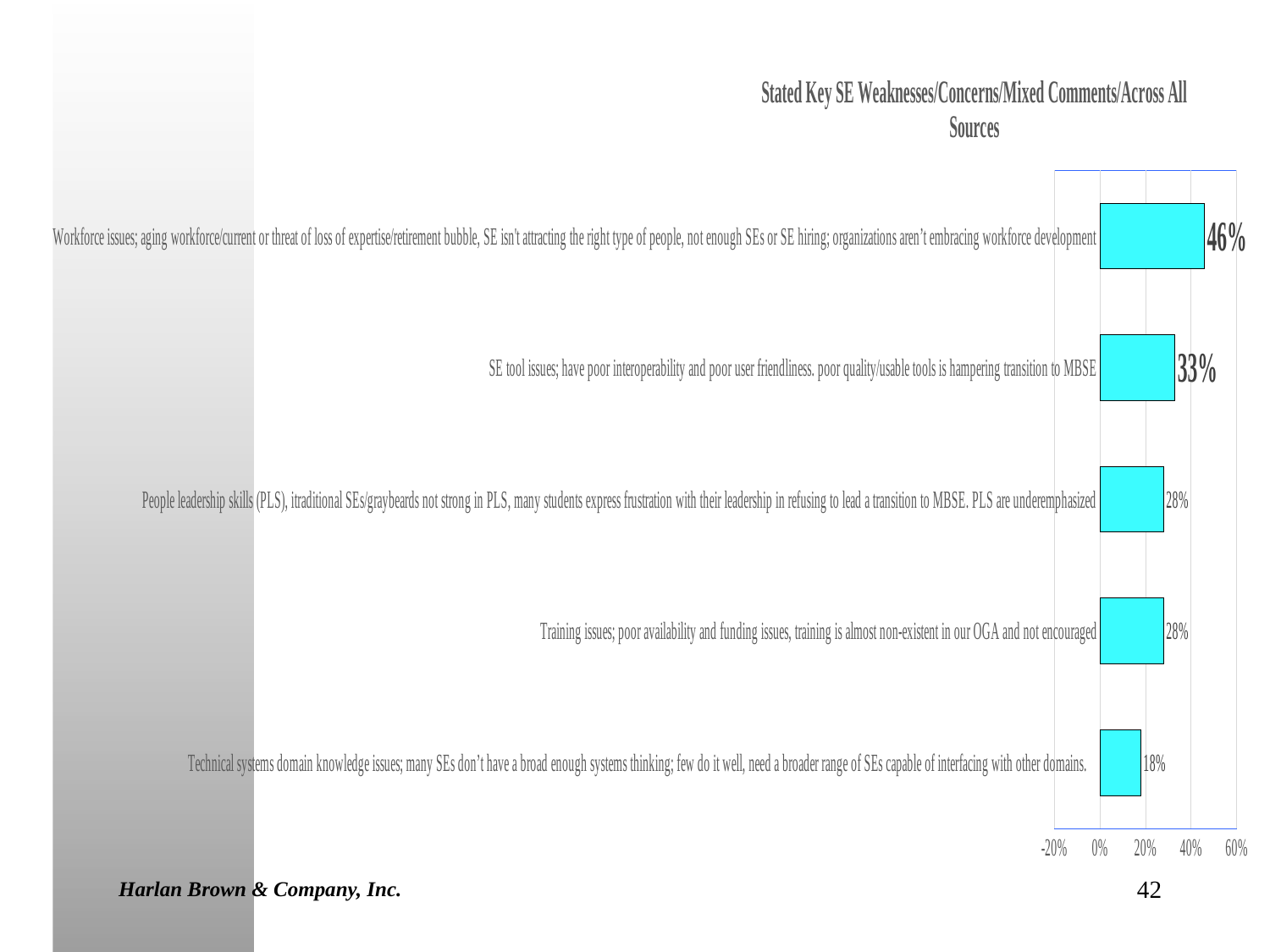
What is the difference between the values for Workforce issues and SE tool issues? 13% What is the title of the chart? Stated Key SE Weaknesses/Concerns/Mixed Comments/Across All Sources How many categories are shown in the chart? 5 Which category has the highest value? Workforce issues What kind of chart is shown on the slide? Bar chart What is the value for Technical systems domain knowledge issues? 18% What is the value for Training issues? 28% What is the value for SE tool issues? 33% What is the value for Workforce issues? 46% What is the difference between the values for People leadership skills (PLS) and Technical systems domain knowledge issues? 10% Which category has the lowest value? Technical systems domain knowledge issues Which is larger, the value for SE tool issues or the value for Training issues? SE tool issues